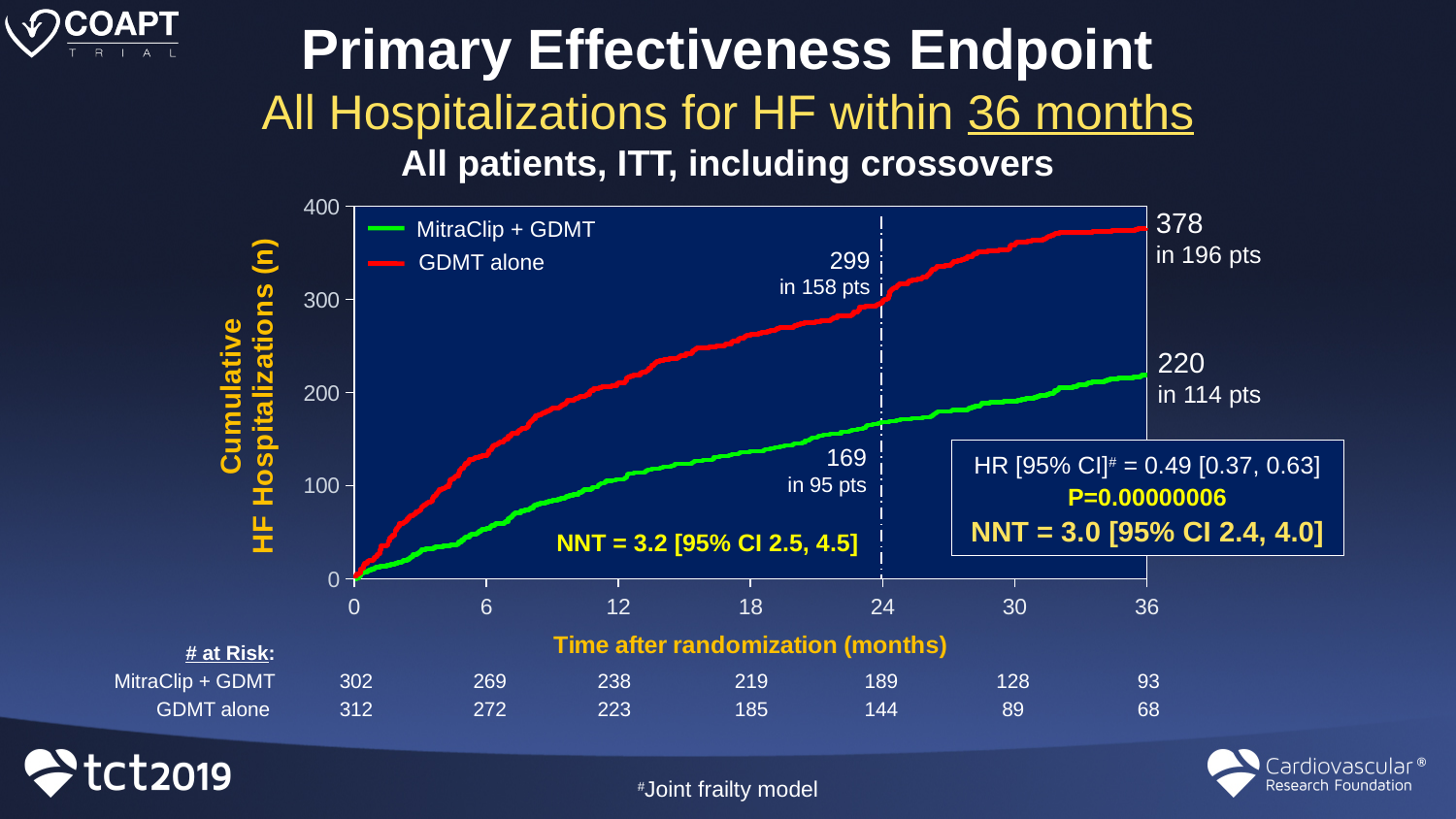
What type of chart is shown on the slide? Line chart What is the cumulative number of HF hospitalizations for MitraClip + GDMT at 36 months? 220 Which series has the higher cumulative HF hospitalizations at 36 months, MitraClip + GDMT or GDMT alone? GDMT alone What is the cumulative number of HF hospitalizations for GDMT alone at 24 months? 299 Do the cumulative HF hospitalizations for GDMT alone rise or fall over time after randomization? Rise Is the value for MitraClip + GDMT at 12 months greater or less than 200? less What is the difference in cumulative HF hospitalizations between GDMT alone and MitraClip + GDMT at 36 months? 158 What is the cumulative number of HF hospitalizations for MitraClip + GDMT at 24 months? 169 What is the difference in cumulative HF hospitalizations between GDMT alone and MitraClip + GDMT at 24 months? 130 How many series does the legend list? 2 Which colour represents the GDMT alone series in the chart? Red What is the cumulative number of HF hospitalizations for GDMT alone at 36 months? 378